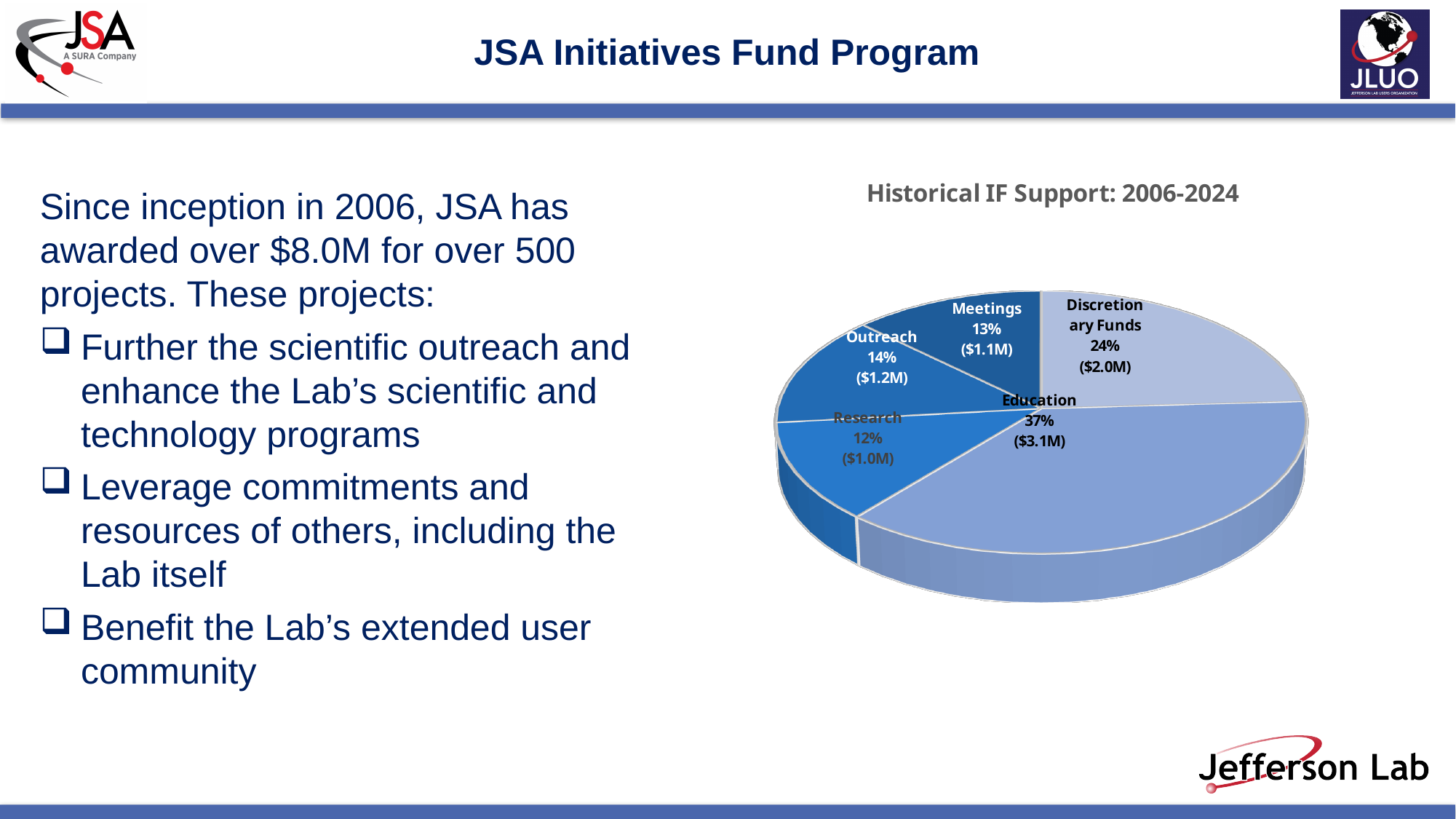
Which category has the largest share of the pie? Education What share of the pie does Education represent? 37% What dollar amount is shown for Research? $1.0M What is the difference in percentage points between Education and Discretionary Funds? 13 Which category has the smallest share of the pie? Research What dollar amount is shown for Discretionary Funds? $2.0M What is the title of the chart? Historical IF Support: 2006-2024 Which has a larger share, Outreach or Research? Outreach What kind of chart is shown on the slide? Pie chart How many slices does the pie chart have? 5 What percentage is shown for Outreach? 14% What dollar amount is shown for Meetings? $1.1M